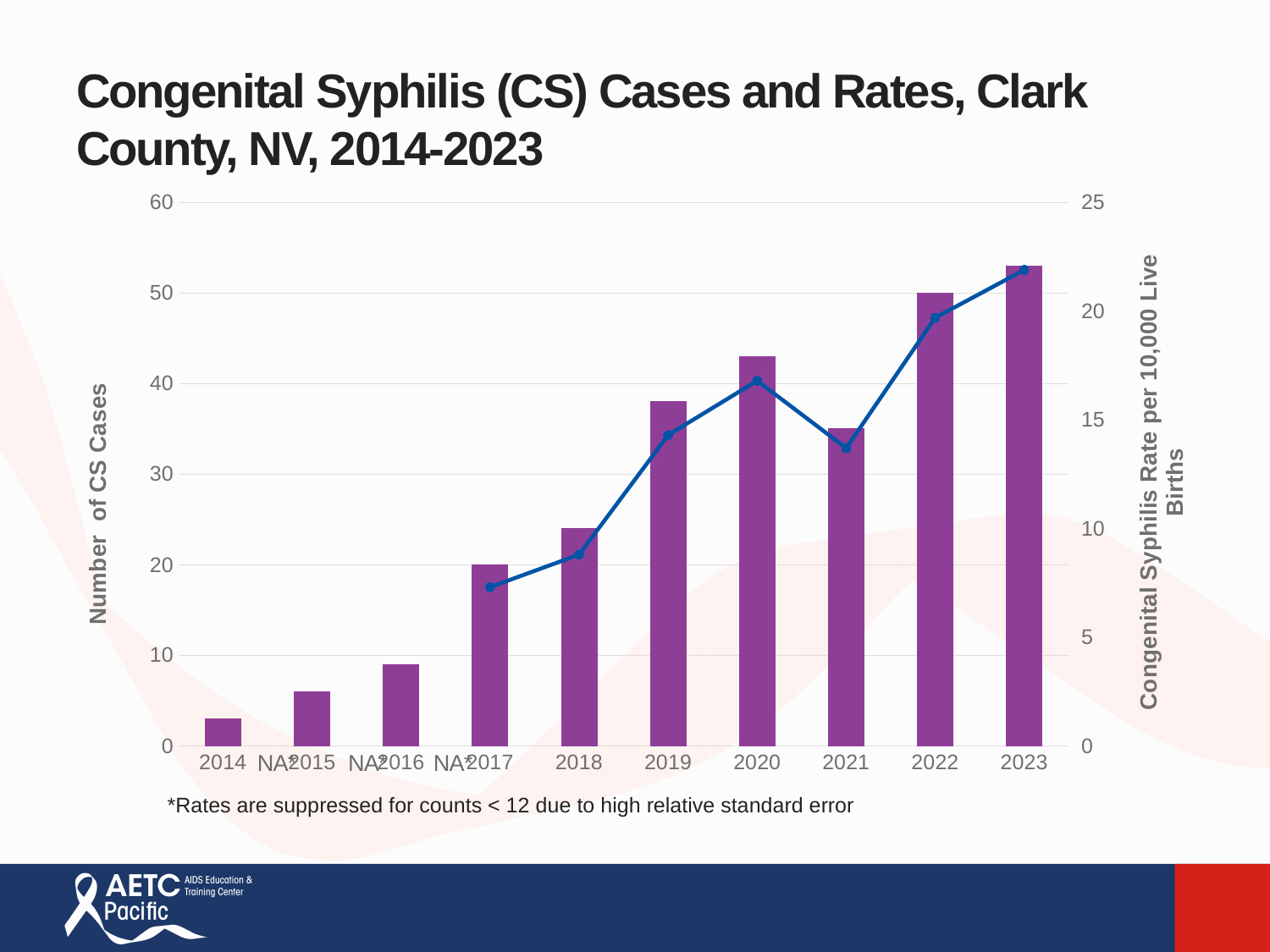
Which year has the lowest number of CS cases? 2014 Do the number of CS cases rise or fall from 2014 to 2020? rise Is the number of CS cases in 2021 greater or less than 40? less Is the CS rate per 10,000 live births in 2020 greater or less than 15? greater Is the CS rate per 10,000 live births in 2017 greater or less than 10? less How many CS cases were reported in 2022? 50 What kind of chart is shown on the slide? A combined bar and line chart Which year has the highest number of CS cases? 2023 How many years are shown along the x axis? 10 For which years is the CS rate marked as NA? 2014, 2015 and 2016 Which year had more CS cases, 2020 or 2021? 2020